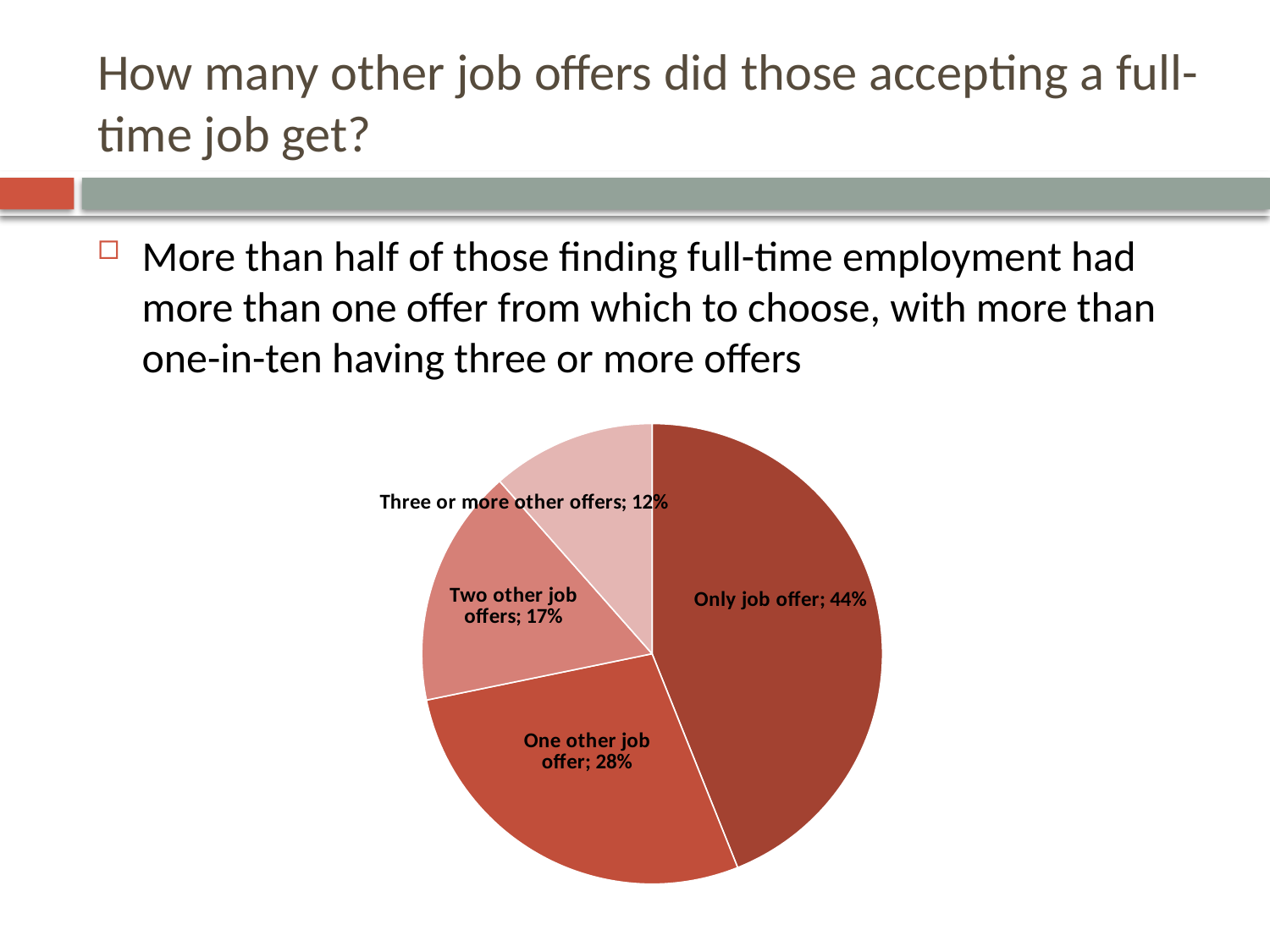
What percentage of those accepting a full-time job had only one job offer? 44% What is the difference in percentage points between 'Two other job offers' and 'Three or more other offers'? 5 Which category has the smallest share of the pie? Three or more other offers How many slices does the pie chart have? 4 What percentage had three or more other job offers? 12% Which category has the largest share of the pie? Only job offer What is the combined share of those with two or more other job offers? 29% What percentage had one other job offer? 28% What kind of chart is shown on the slide? Pie chart Which is larger: the share for 'One other job offer' or 'Two other job offers'? One other job offer What percentage had two other job offers? 17% What is the difference in percentage points between 'Only job offer' and 'One other job offer'? 16